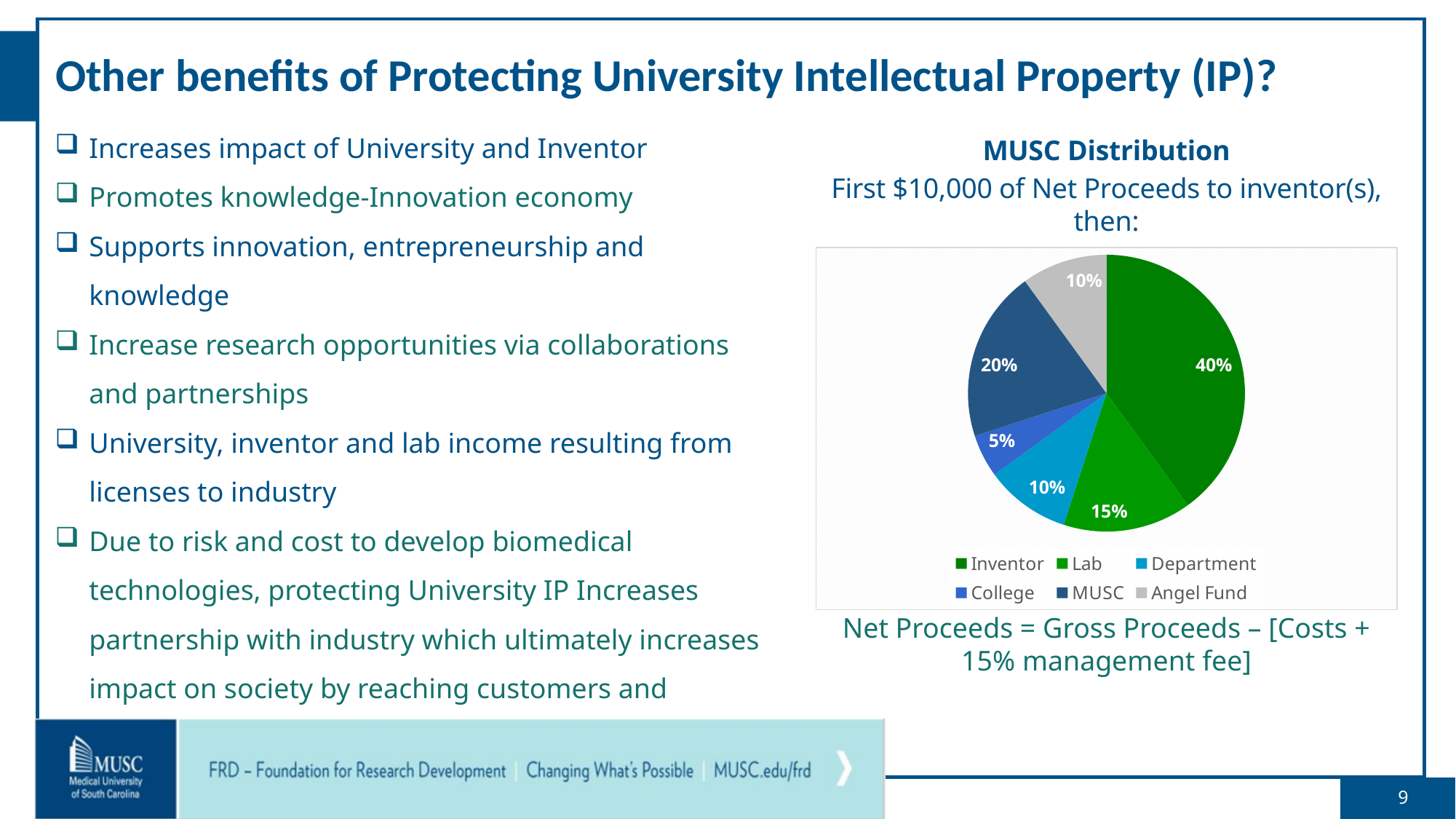
What share of the pie does College receive? 5% What share of the pie does Angel Fund receive? 10% What share of the pie does Inventor receive? 40% Which category has the smallest slice of the pie? College What share of the pie does Lab receive? 15% What is the title of the pie chart? MUSC Distribution Which slice is larger, Lab or Department? Lab What share of the pie does MUSC receive? 20% Which category has the largest slice of the pie? Inventor How many categories does the pie chart have? 6 What is the difference in percentage points between the Inventor slice and the MUSC slice? 20 What kind of chart is shown on the slide? pie chart